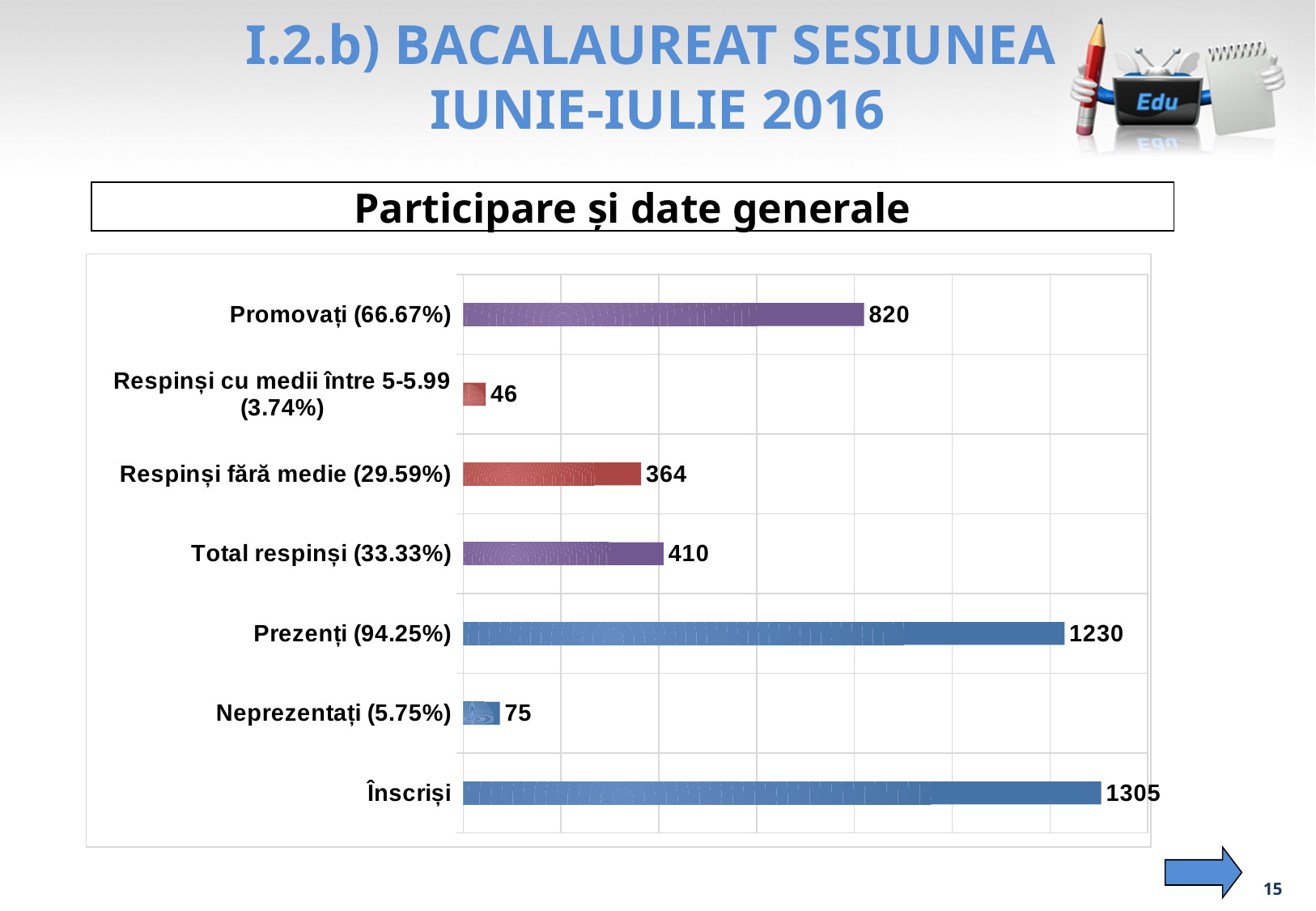
What is the value for Respinși cu medii între 5-5.99 (3.74%)? 46 What is the difference between Înscriși and Prezenți (94.25%)? 75 Which is larger, Respinși fără medie (29.59%) or Total respinși (33.33%)? Total respinși (33.33%) Which category has the lowest value? Respinși cu medii între 5-5.99 (3.74%) What is the value for Neprezentați (5.75%)? 75 What is the difference between Promovați (66.67%) and Total respinși (33.33%)? 410 What is the value for Promovați (66.67%)? 820 Which category has the highest value? Înscriși What is the value for Înscriși? 1305 What kind of chart is shown on the slide? bar chart How many categories are shown in the chart? 7 What is the title shown above the chart? Participare și date generale